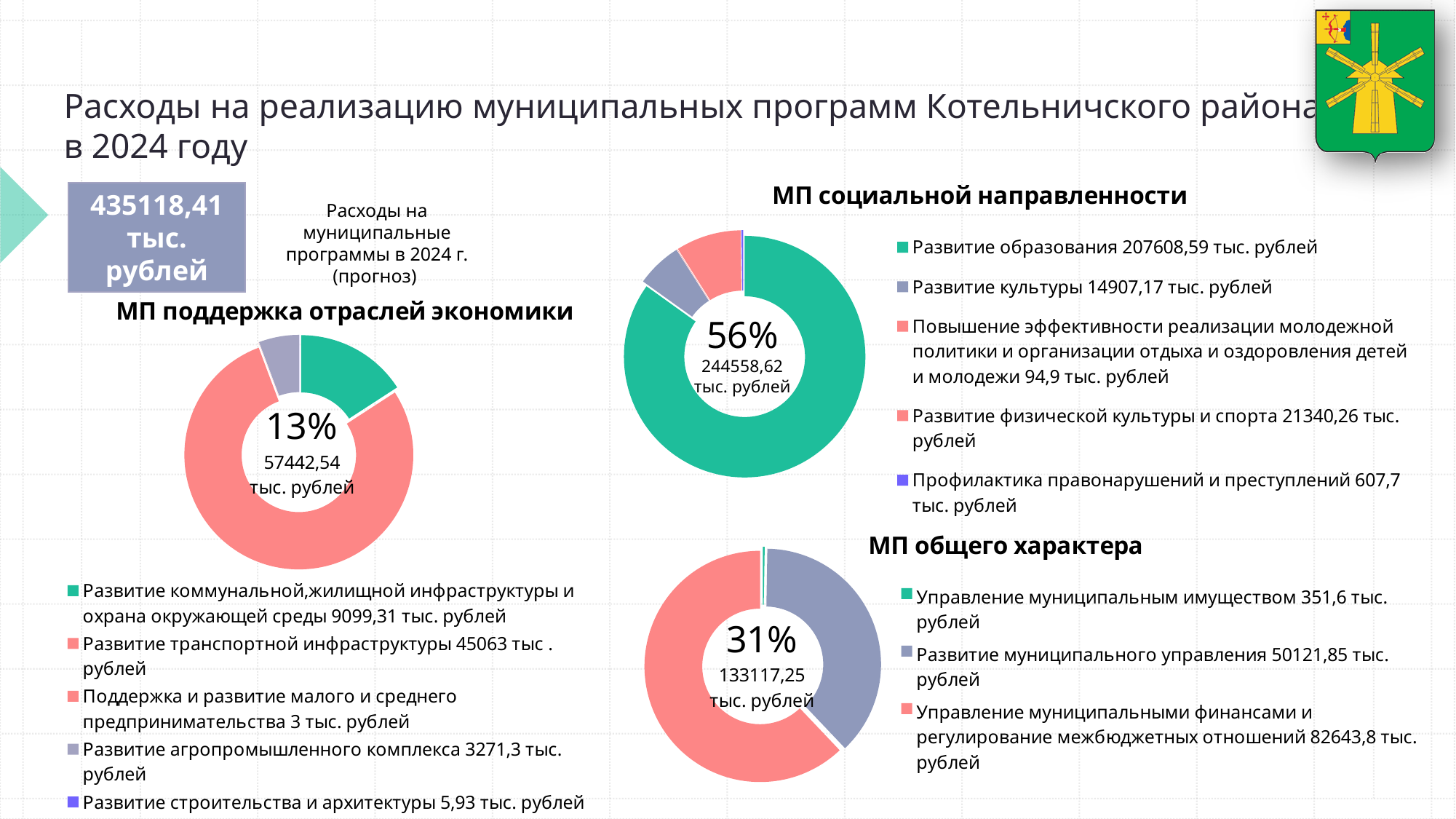
In the "МП общего характера" chart, what is the difference between "Управление муниципальными финансами и регулирование межбюджетных отношений" and "Развитие муниципального управления"? 32521,95 тыс. рублей How many categories does the legend of the "МП социальной направленности" chart list? 5 What percentage is shown in the centre of the "МП социальной направленности" chart? 56% In the "МП поддержка отраслей экономики" chart, what is the value for "Развитие транспортной инфраструктуры"? 45063 тыс. рублей In the "МП общего характера" chart, what is the value for "Развитие муниципального управления"? 50121,85 тыс. рублей In the "МП социальной направленности" chart, which is larger: "Развитие культуры" or "Развитие физической культуры и спорта"? Развитие физической культуры и спорта In the "МП поддержка отраслей экономики" chart, which category has the smallest value? Поддержка и развитие малого и среднего предпринимательства In the "МП общего характера" chart, which category has the largest value? Управление муниципальными финансами и регулирование межбюджетных отношений In the "МП социальной направленности" chart, what is the value for "Развитие образования"? 207608,59 тыс. рублей What type of chart is used for "МП поддержка отраслей экономики"? Pie (donut) chart In the "МП социальной направленности" chart, which category has the smallest value? Повышение эффективности реализации молодежной политики и организации отдыха и оздоровления детей и молодежи How many categories does the legend of the "МП общего характера" chart list? 3